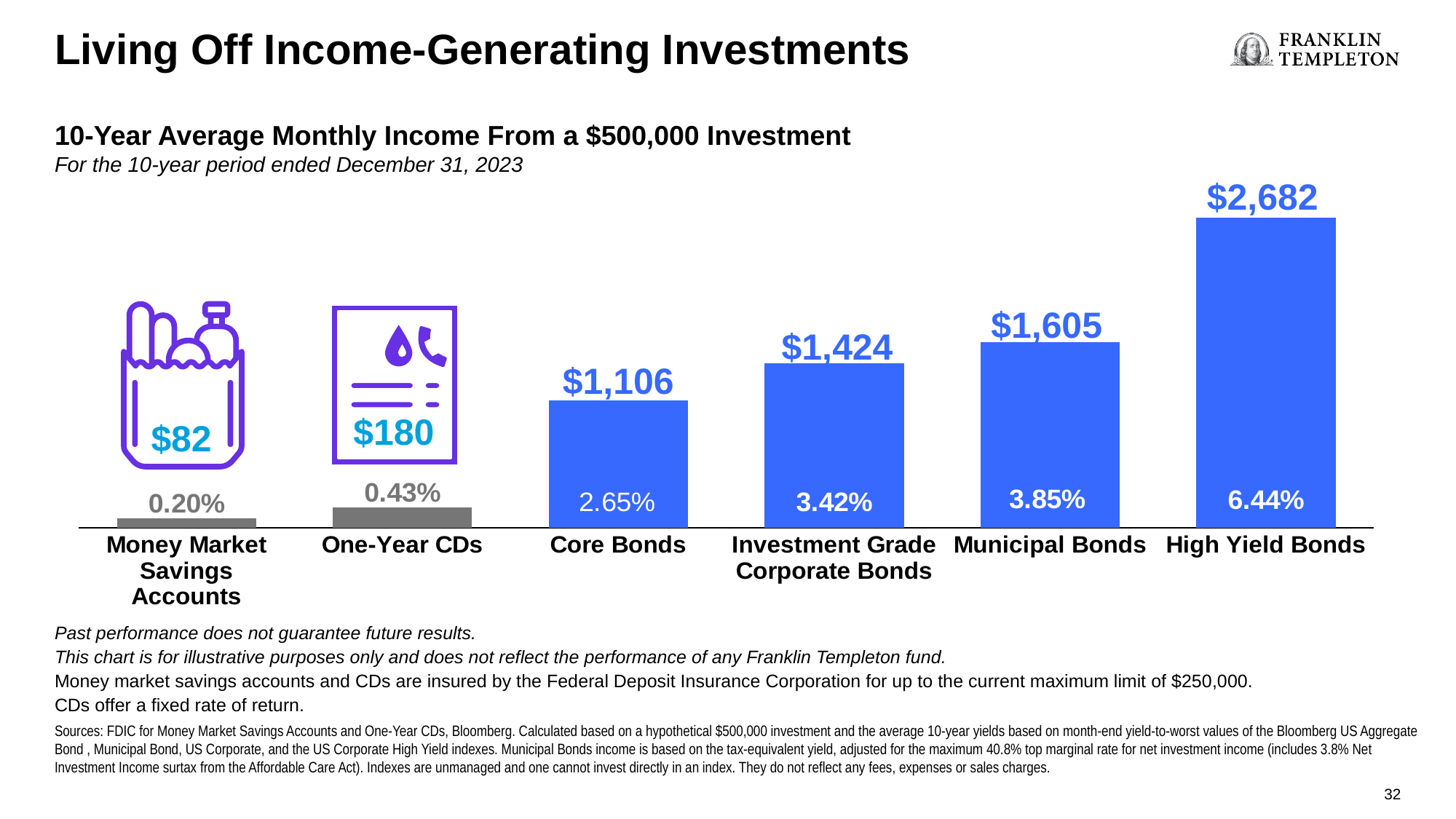
What is the average monthly income shown for Money Market Savings Accounts? $82 Which category has the lowest average monthly income? Money Market Savings Accounts What is the average monthly income shown for High Yield Bonds? $2,682 What is the difference in monthly income between Investment Grade Corporate Bonds and Core Bonds? $318 Which has a higher monthly income, One-Year CDs or Core Bonds? Core Bonds What type of chart is shown on the slide? Bar chart What yield percentage is shown for Municipal Bonds? 3.85% Which category has the highest average monthly income? High Yield Bonds What is the average monthly income shown for Core Bonds? $1,106 How many investment categories are shown in the chart? 6 Do the monthly income values rise or fall moving from left to right across the categories? Rise What is the difference in monthly income between High Yield Bonds and Municipal Bonds? $1,077